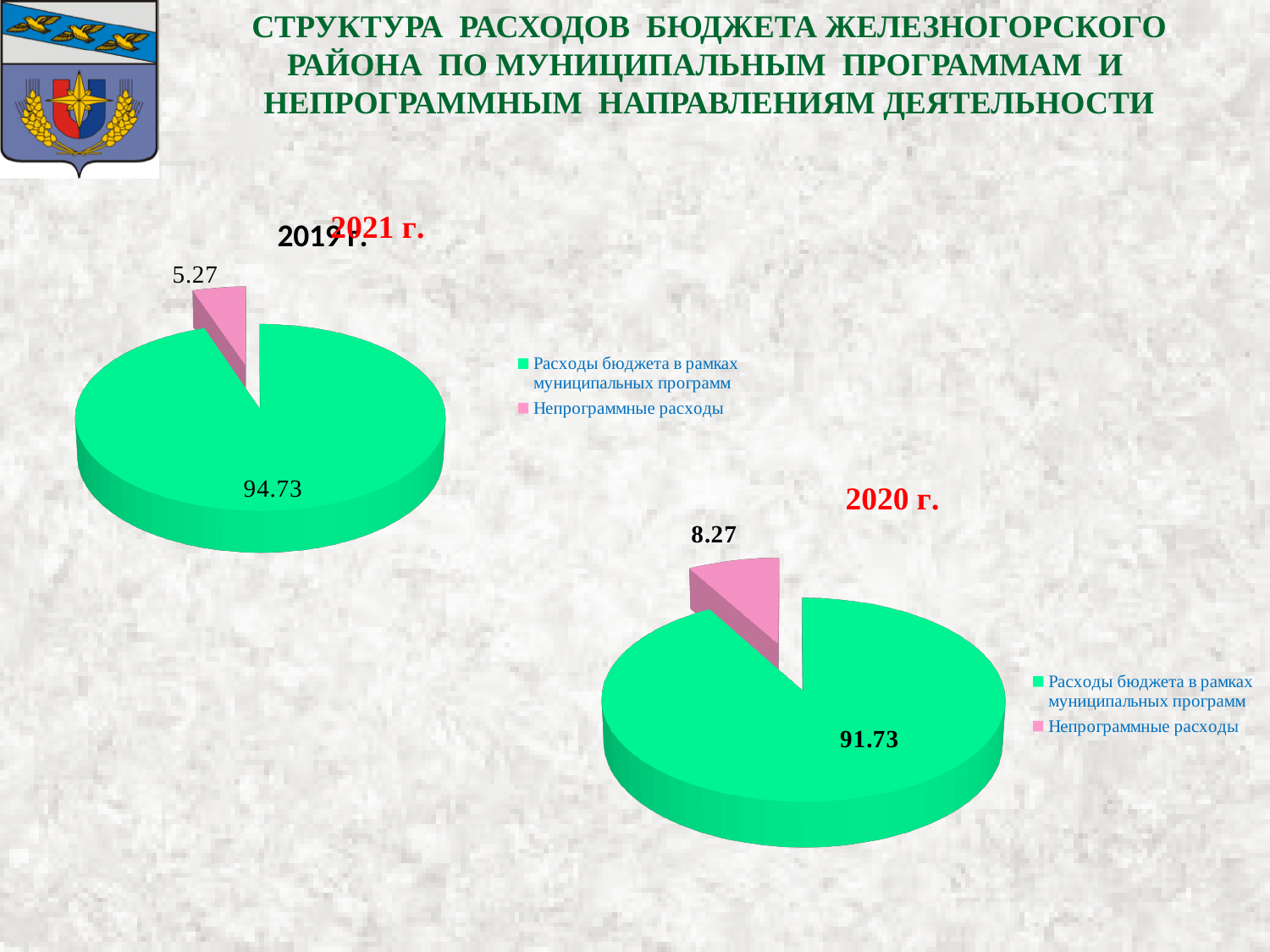
In the pie chart on the left of the slide, what is the value for Расходы бюджета в рамках муниципальных программ? 94.73 In the pie chart on the left of the slide, which category has the smallest slice? Непрограммные расходы In the pie chart titled 2020 г., what is the value for Непрограммные расходы? 8.27 How many entries does the legend of the pie chart on the left of the slide list? 2 In the pie chart titled 2020 г., what is the value for Расходы бюджета в рамках муниципальных программ? 91.73 In the pie chart titled 2020 г., which category has the largest slice? Расходы бюджета в рамках муниципальных программ In the pie chart on the left of the slide, what is the value for Непрограммные расходы? 5.27 In the pie chart titled 2020 г., what is the difference between the two slice values? 83.46 What kind of chart is the chart titled 2020 г.? Pie chart In the pie chart titled 2020 г., what colour is the slice for Непрограммные расходы? Pink How many slices does the pie chart titled 2020 г. have? 2 Is the value for Непрограммные расходы larger in the pie chart on the left of the slide or in the pie chart titled 2020 г.? 2020 г.